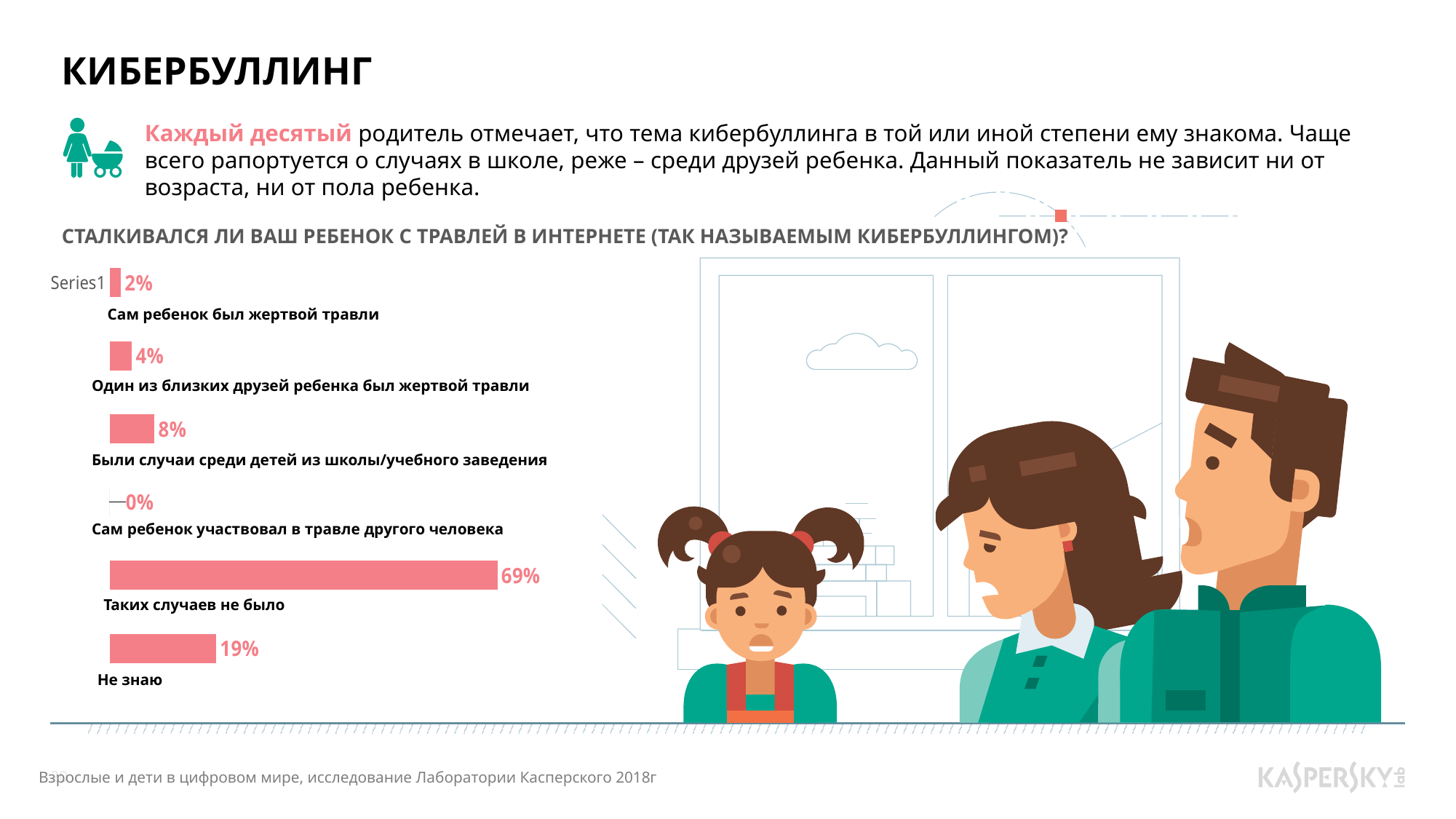
What is the difference between "Таких случаев не было" and "Не знаю"? 50% What percentage of parents answered "Таких случаев не было"? 69% Which category has the highest value? Таких случаев не было Which category has the lowest value? Сам ребенок участвовал в травле другого человека What is the title of the chart? СТАЛКИВАЛСЯ ЛИ ВАШ РЕБЕНОК С ТРАВЛЕЙ В ИНТЕРНЕТЕ (ТАК НАЗЫВАЕМЫМ КИБЕРБУЛЛИНГОМ)? Which is larger: "Один из близких друзей ребенка был жертвой травли" or "Были случаи среди детей из школы/учебного заведения"? Были случаи среди детей из школы/учебного заведения What is the value for "Были случаи среди детей из школы/учебного заведения"? 8% How many categories does the chart show? 6 What is the value for "Не знаю"? 19% What type of chart is shown on the slide? Bar chart What is the value for "Сам ребенок был жертвой травли"? 2% What is the value for "Сам ребенок участвовал в травле другого человека"? 0%